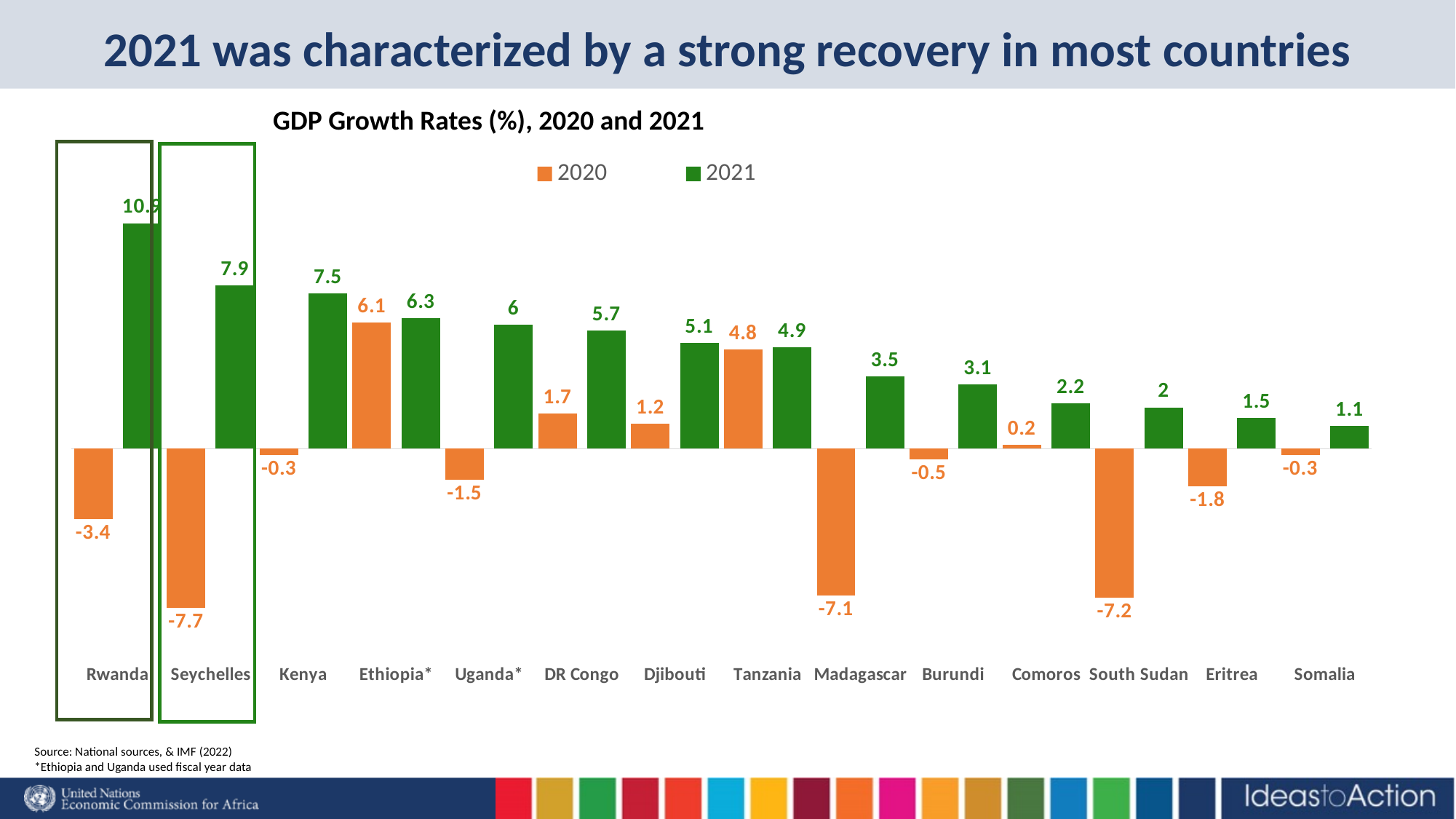
What was Madagascar's GDP growth rate in 2020? -7.1 What was Seychelles' GDP growth rate in 2021? 7.9 Which was larger, Tanzania's GDP growth rate in 2020 or in 2021? 2021 What kind of chart is shown on the slide? Bar chart What colour represents the 2020 series in the chart? Orange Which country had the highest GDP growth rate in 2021? Rwanda What is the difference between Kenya's 2021 and 2020 GDP growth rates? 7.8 How many countries are shown on the chart? 14 Which country had the lowest GDP growth rate in 2021? Somalia Which country had the lowest GDP growth rate in 2020? Seychelles What was Ethiopia's GDP growth rate in 2020? 6.1 How many series does the legend list? 2